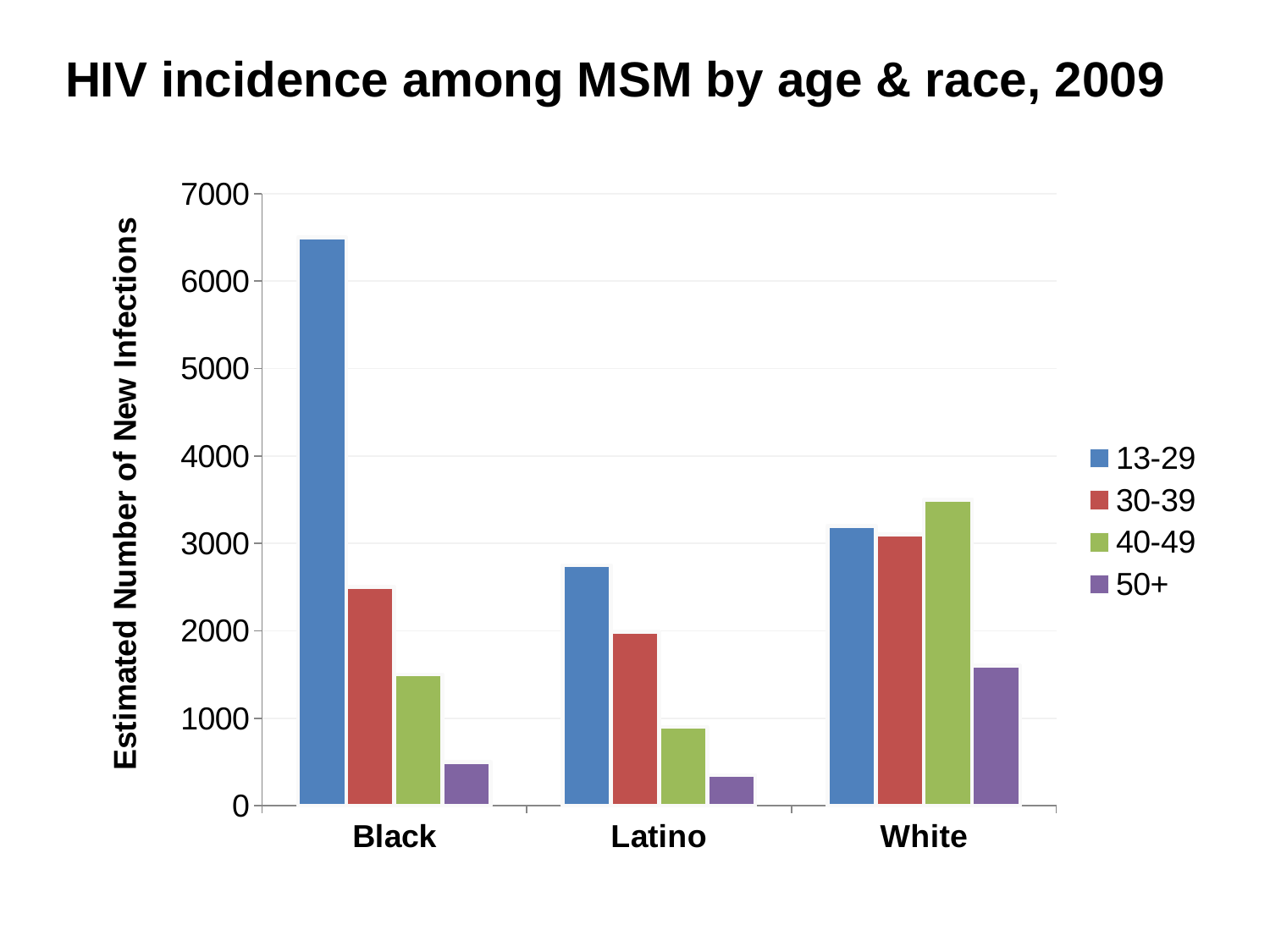
What kind of chart is shown on the slide? bar chart Among White MSM, which age group has the highest estimated number of new infections? 40-49 Is the value for the 13-29 age group among Black MSM greater or less than 6000? greater Is the value for the 50+ age group among White MSM greater or less than 1000? greater Is the value for the 13-29 age group among Latino MSM greater or less than 3000? less Which is larger: the 30-39 value for Black MSM or the 30-39 value for Latino MSM? Black How many series does the legend list? 4 How many race categories are shown on the x axis? 3 Which race and age group has the highest estimated number of new infections? Black, 13-29 What is the label of the y axis? Estimated Number of New Infections